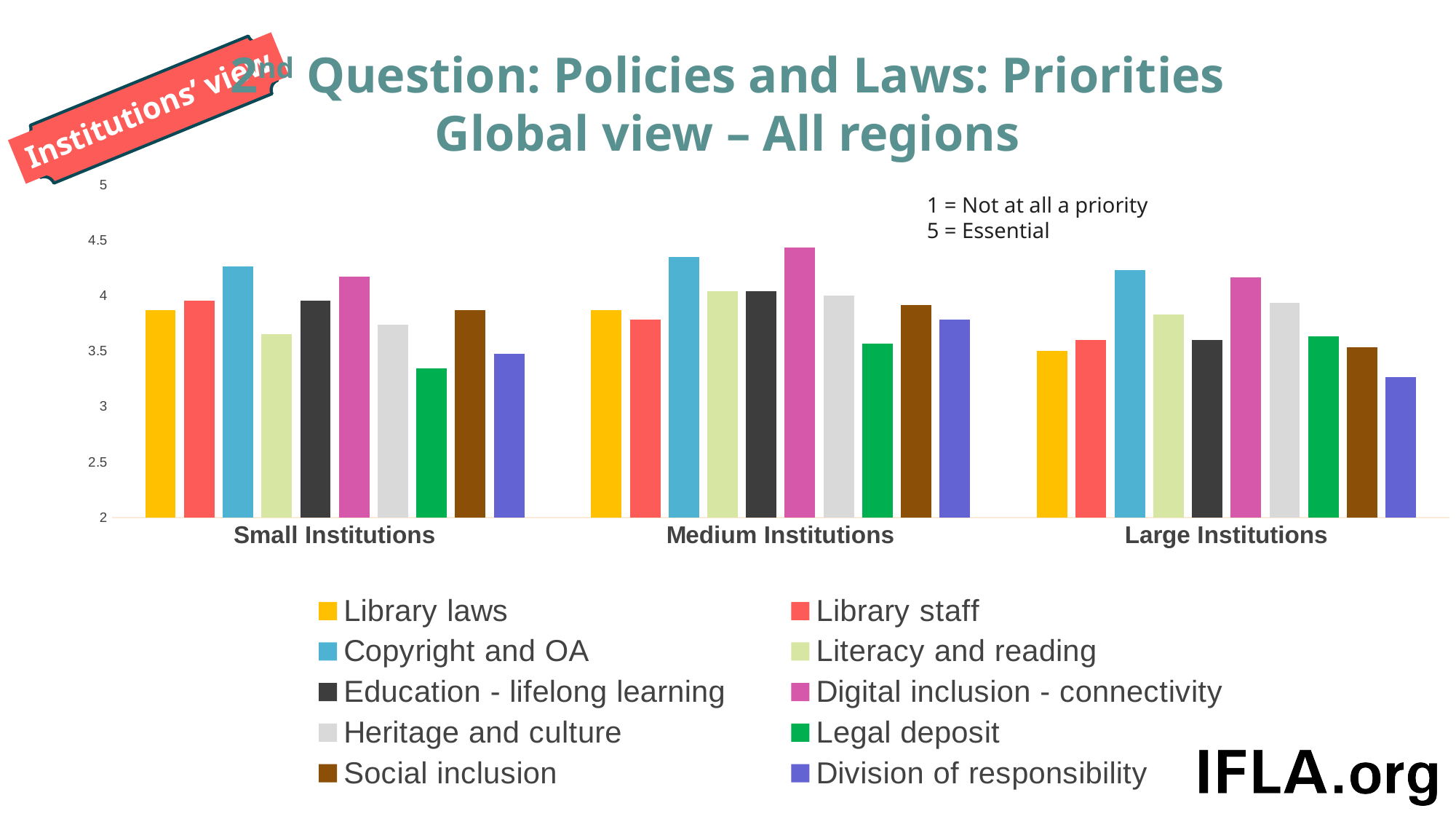
Which series has the lowest value for Large Institutions? Division of responsibility Which series has the highest value for Small Institutions? Copyright and OA How many series does the legend list? 10 Is the value for Division of responsibility at Large Institutions greater or less than 3.5? less What kind of chart is shown on the slide? bar chart Is the value for Copyright and OA at Small Institutions greater or less than 4? greater For Library laws, which is larger: the value for Small Institutions or for Large Institutions? Small Institutions According to the note on the chart, what does a rating of 5 mean? Essential How many institution-size categories are shown on the x axis? 3 For Large Institutions, which is larger: Copyright and OA or Library laws? Copyright and OA Which series has the lowest value for Small Institutions? Legal deposit Which series has the highest value for Medium Institutions? Digital inclusion - connectivity